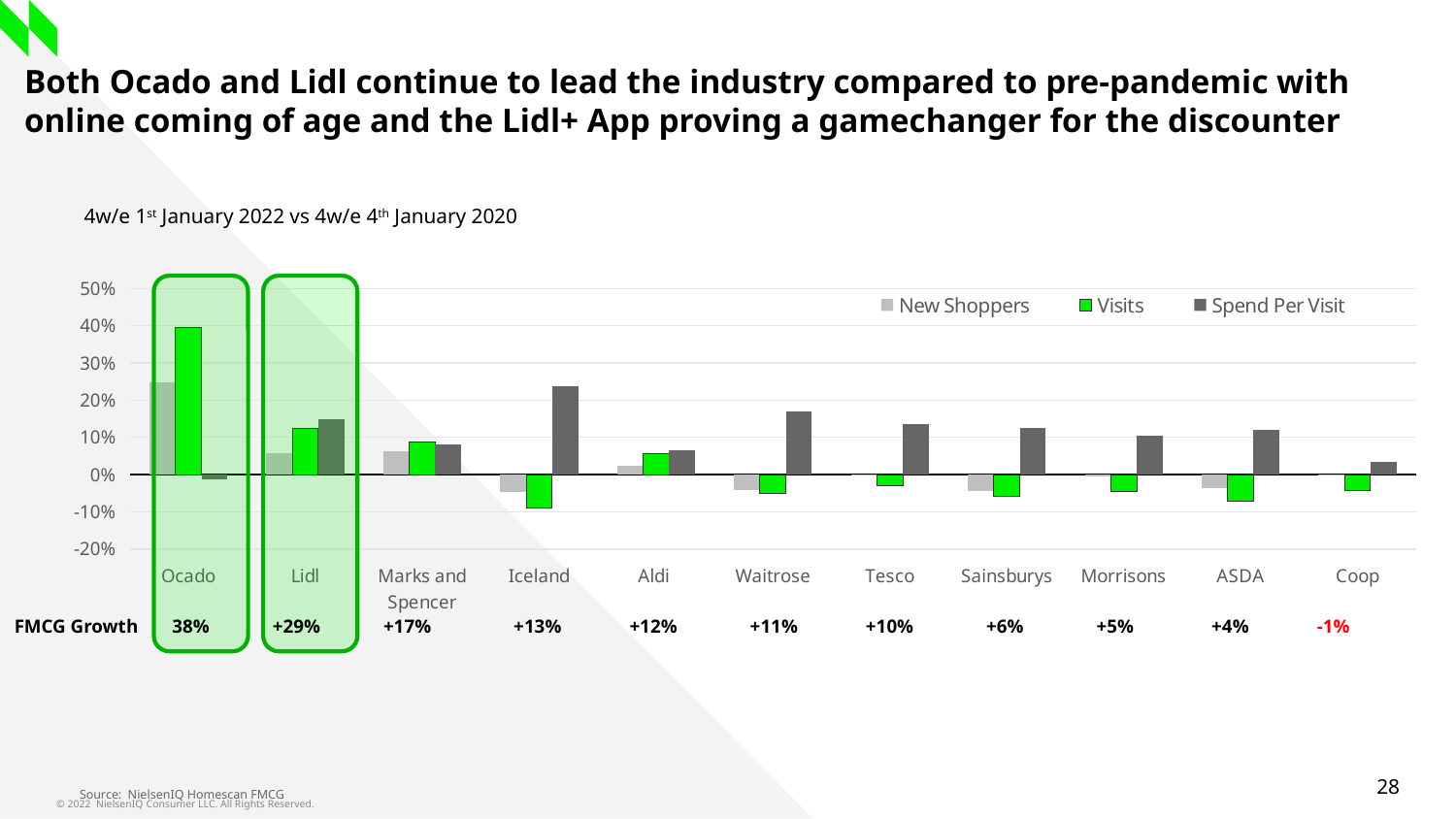
Is the Visits value for Ocado greater or less than 30%? greater What is the difference between the FMCG Growth values for Ocado and Lidl? 9 percentage points Which retailer has the highest Spend Per Visit bar? Iceland Which retailer has the highest Visits bar? Ocado What is the FMCG Growth value shown for Coop? -1% How many retailers are shown on the x axis of the chart? 11 Which retailer has the lowest FMCG Growth value? Coop Is the Visits value for Iceland greater or less than 0%? less What is the FMCG Growth value shown for Tesco? +10% How many series does the legend list? 3 What is the FMCG Growth value shown for Ocado? 38% What kind of chart is shown on the slide? bar chart